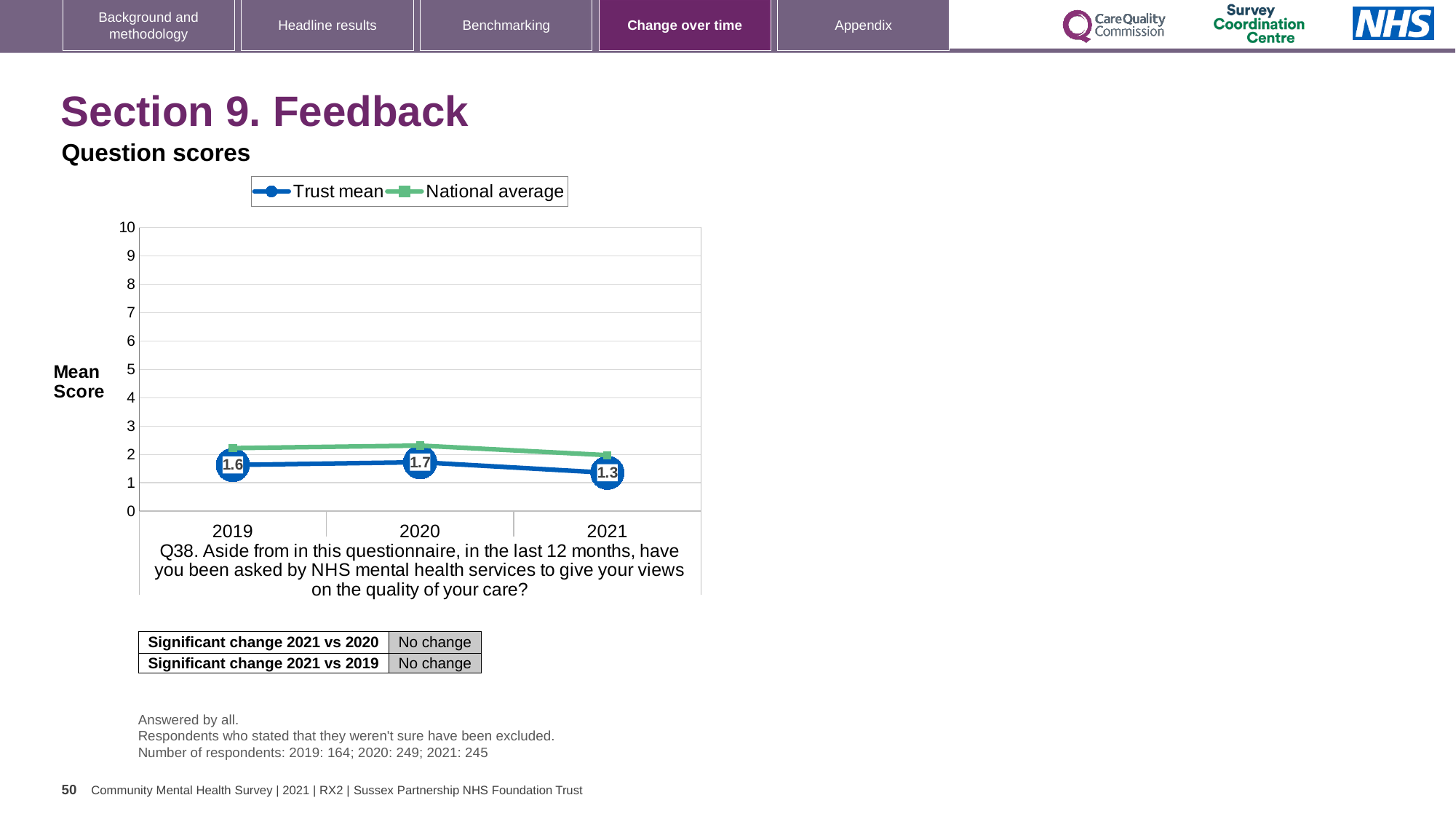
What is the Trust mean score for 2020? 1.7 In which year is the Trust mean score highest? 2020 How many series does the legend list? 2 Is the National average value for 2020 greater or less than 2? greater What is the Trust mean score for 2019? 1.6 What is the Trust mean score for 2021? 1.3 In which year is the Trust mean score lowest? 2021 Does the Trust mean score rise or fall from 2020 to 2021? Fall How many years are plotted on the x axis? 3 What is the difference between the Trust mean scores for 2020 and 2021? 0.4 Which is larger, the Trust mean score for 2019 or for 2021? 2019 What kind of chart is shown on the slide? Line chart